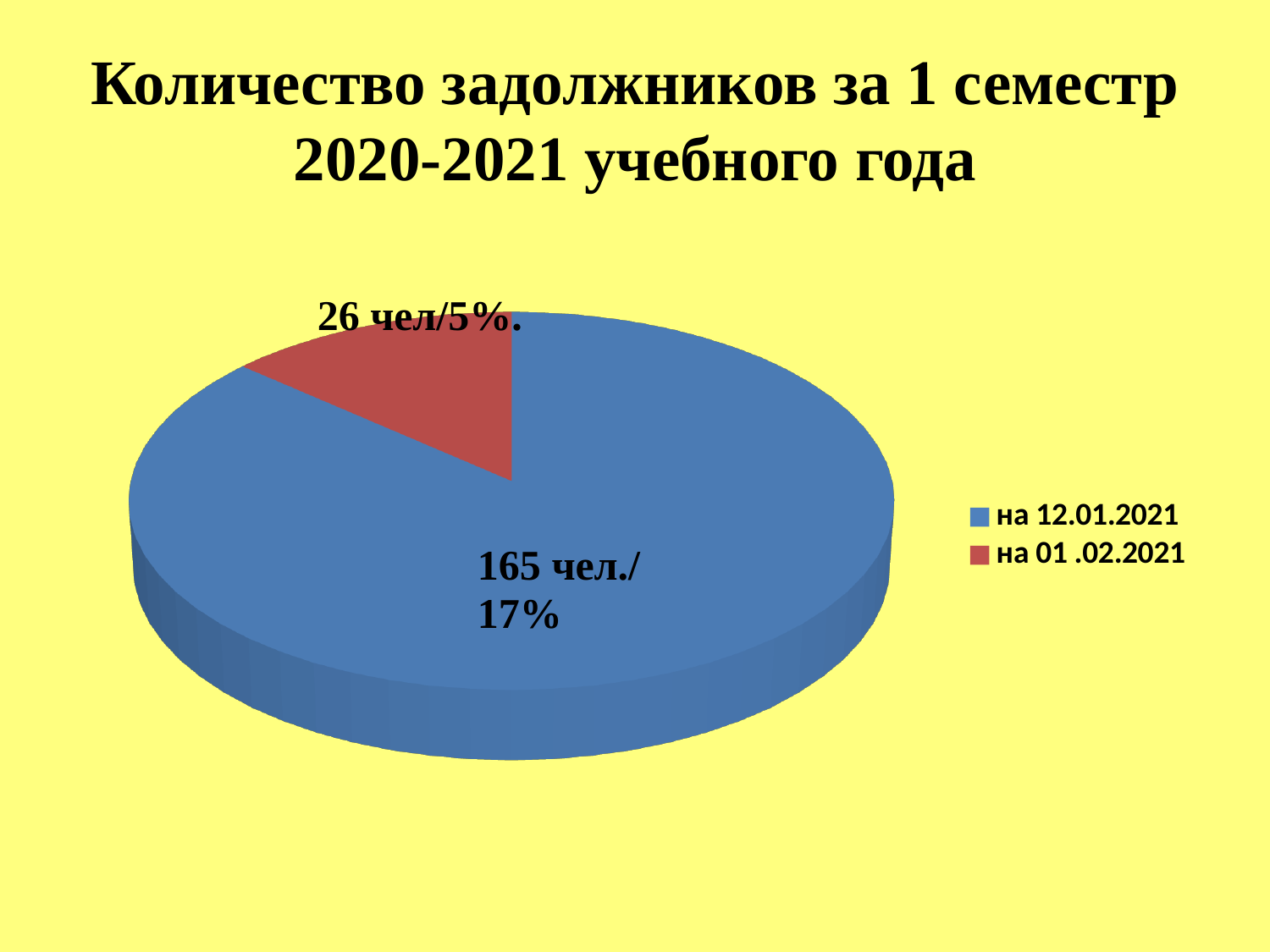
How many people (чел) are shown for "на 12.01.2021"? 165 How many people (чел) are shown for "на 01 .02.2021"? 26 What is the data label shown for the slice "на 01 .02.2021"? 26 чел/5% Which category has the largest slice of the pie? на 12.01.2021 Which colour represents "на 01 .02.2021" in the pie chart? Red What is the data label shown for the slice "на 12.01.2021"? 165 чел./17% What is the title of the chart on the slide? Количество задолжников за 1 семестр 2020-2021 учебного года Which category has the smallest slice of the pie? на 01 .02.2021 What kind of chart is shown on the slide? Pie chart What is the difference in the number of people between "на 12.01.2021" and "на 01 .02.2021"? 139 How many slices does the pie chart have? 2 How many entries does the legend list? 2